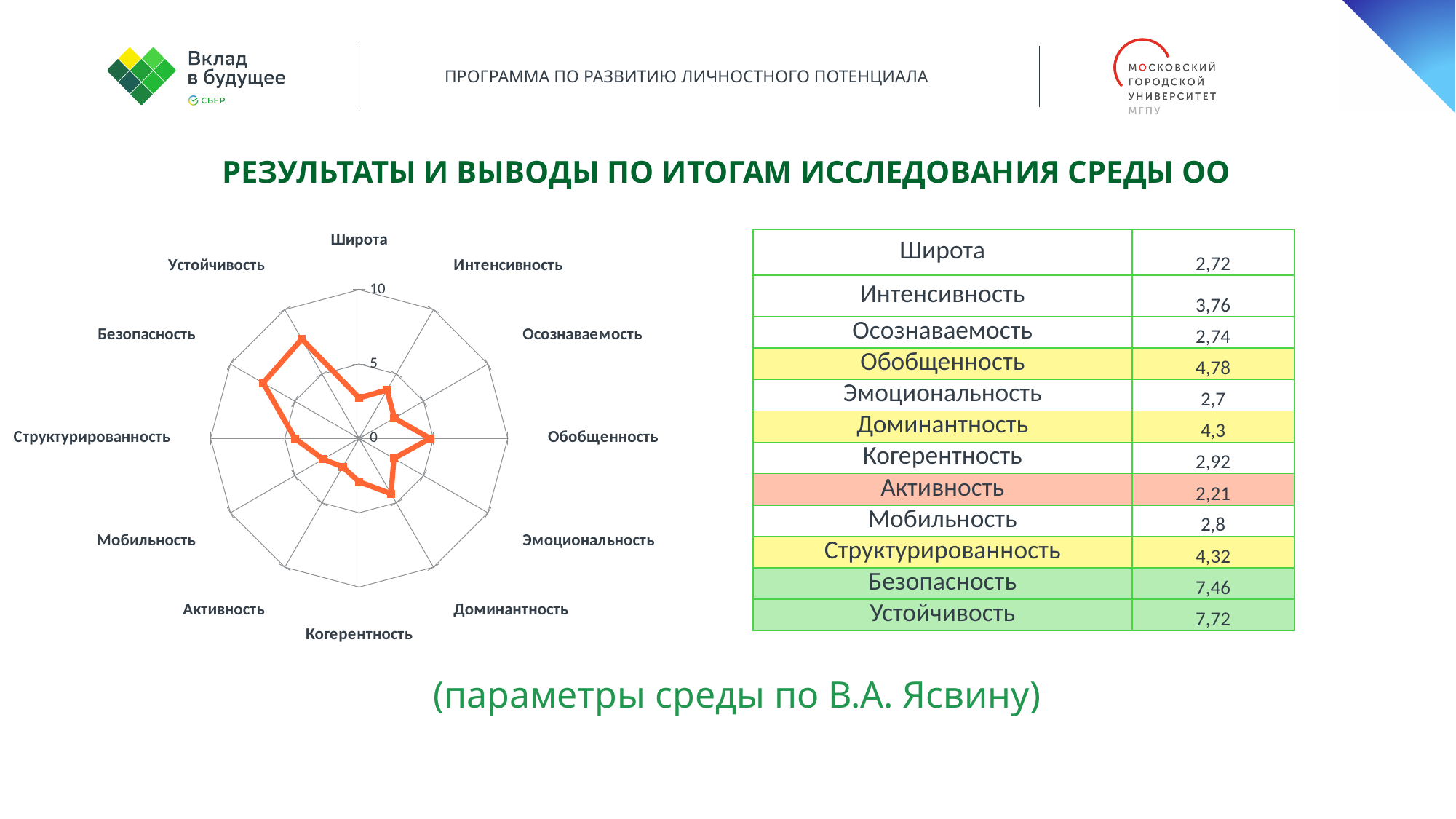
How many parameters (categories) are plotted on the radar chart? 12 What is the value for Активность? 2,21 What is the difference between the values for Устойчивость and Безопасность? 0,26 What is the value for Устойчивость? 7,72 What kind of chart is shown on the slide? Radar chart What is the value for Обобщенность? 4,78 Which parameter has the highest value? Устойчивость Is the value for Безопасность on the radar chart greater or less than 5? greater What is the maximum value shown on the radar chart's axis? 10 Which parameter has the lowest value? Активность What is the value for Структурированность? 4,32 Which is larger, the value for Интенсивность or the value for Широта? Интенсивность